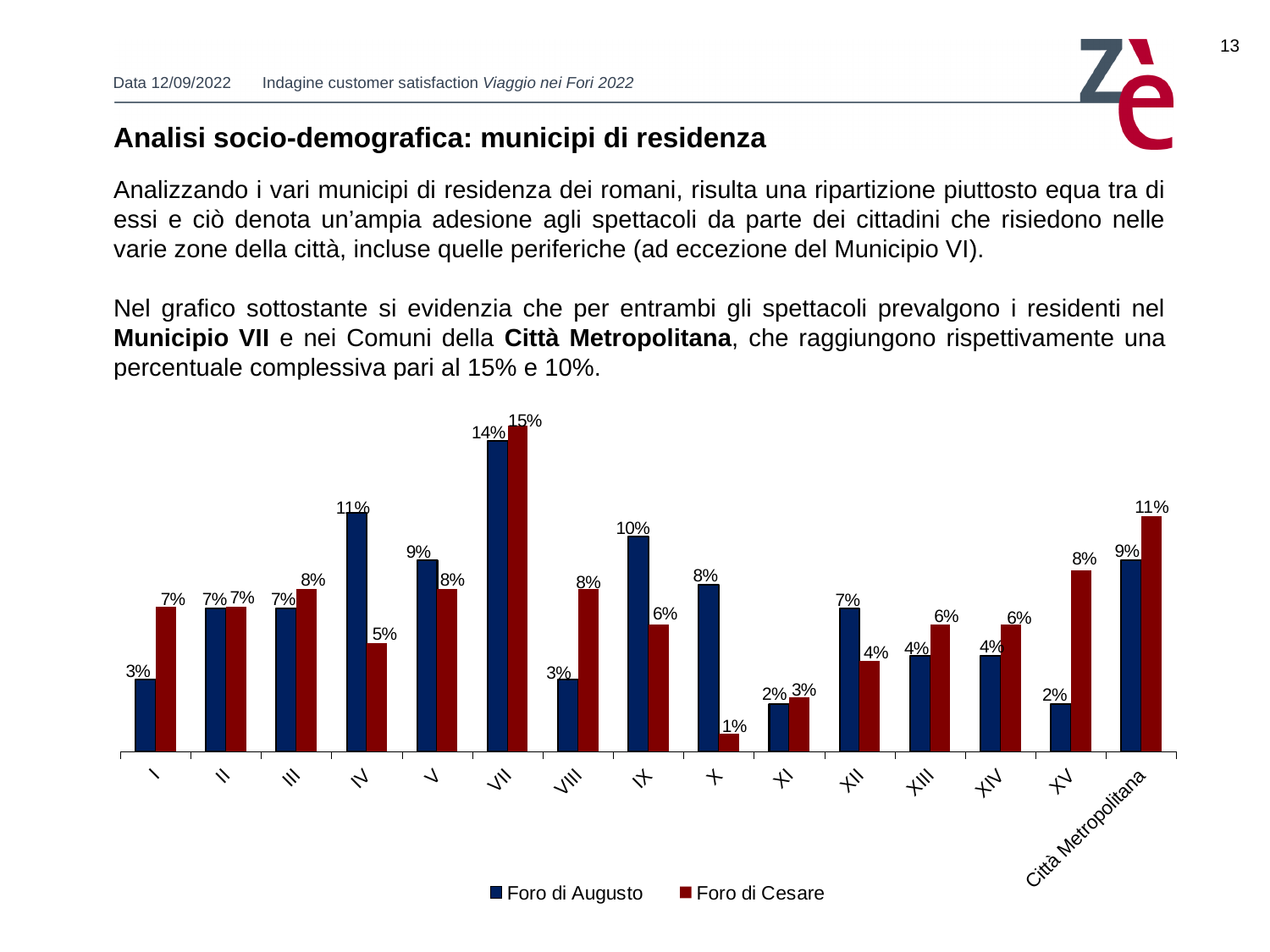
What kind of chart is shown on the slide? Bar chart Which series is shown in dark blue in the legend? Foro di Augusto Which category has the highest value for Foro di Cesare? VII How many series does the legend list? 2 What is the value for Foro di Cesare in Città Metropolitana? 11% What is the value for Foro di Cesare in Municipio X? 1% What is the value for Foro di Augusto in Municipio VII? 14% Which category has the lowest value for Foro di Cesare? X In Municipio XV, which series has the larger value, Foro di Augusto or Foro di Cesare? Foro di Cesare What is the value for Foro di Augusto in Municipio IV? 11% How many categories are shown on the x axis? 15 What is the difference between the Foro di Augusto and Foro di Cesare values in Municipio IV? 6%